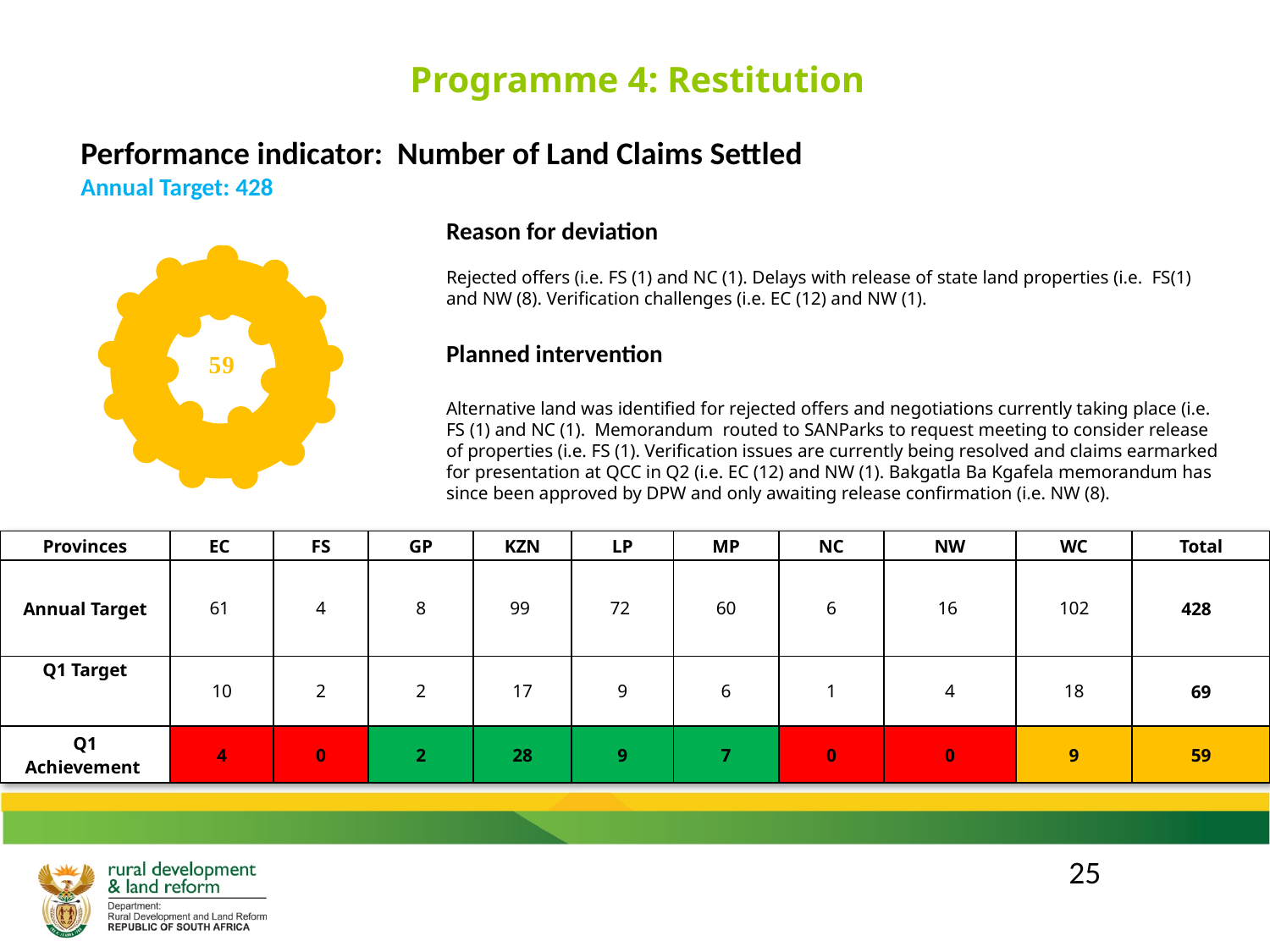
What colour is the ring chart on the left of the slide? yellow Is the value shown in the centre of the ring chart greater or less than 100? less What kind of chart is shown on the left of the slide? doughnut chart Is the value shown in the centre of the ring chart greater or less than 50? greater What number is displayed in the centre of the ring chart on the left of the slide? 59